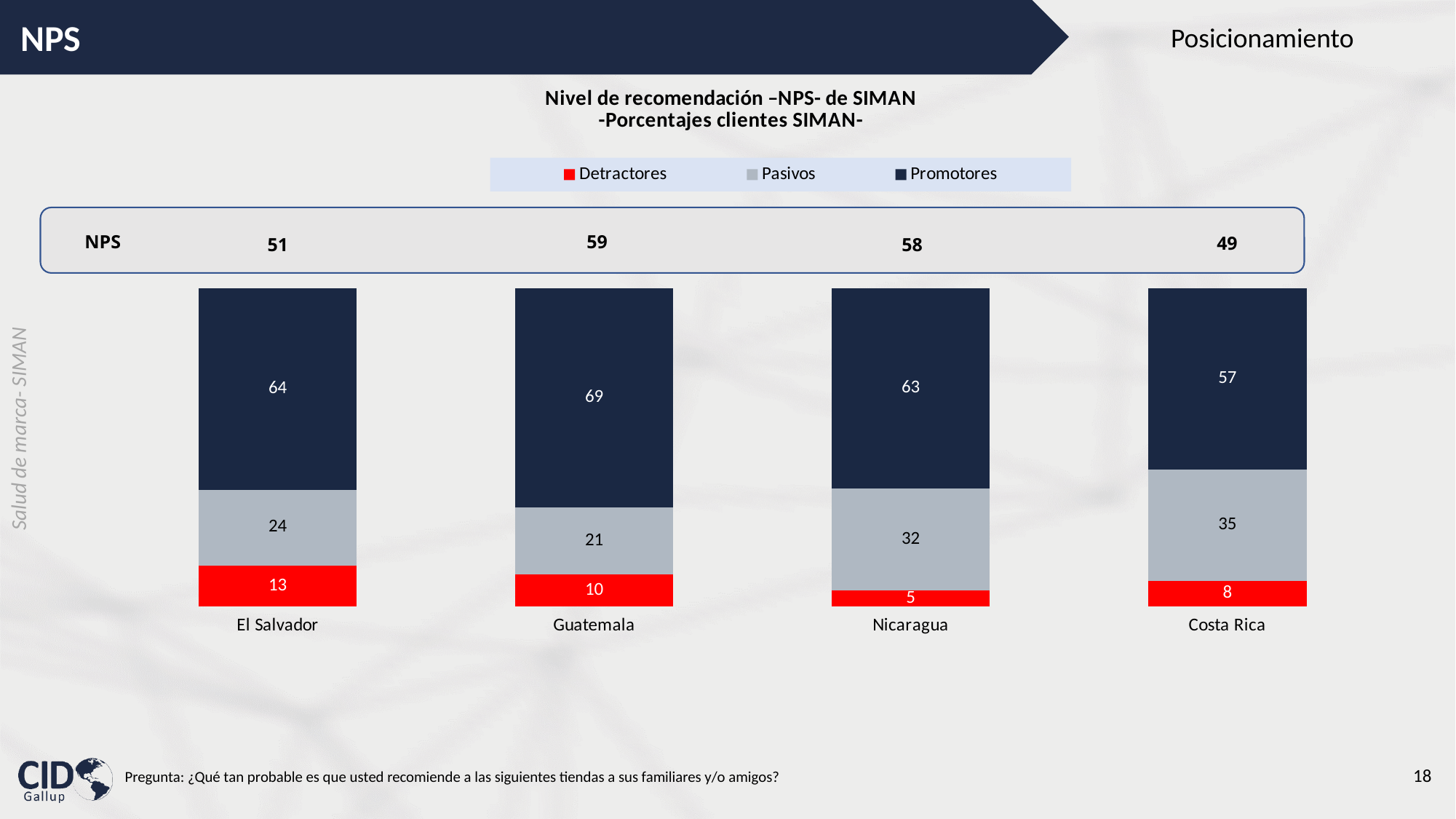
What is the difference between the Promotores values for El Salvador and Costa Rica? 7 Which country has the highest Promotores value? Guatemala Which country has the lowest Detractores value? Nicaragua What kind of chart is shown? Stacked bar chart What is the Pasivos value for Nicaragua? 32 How many countries are shown on the x axis? 4 What is the Promotores value for Guatemala? 69 Which colour represents Detractores in the legend? Red Which is larger, the Pasivos value for Costa Rica or for El Salvador? Costa Rica How many series does the legend list? 3 What is the total of the stacked bar for Nicaragua? 100 What is the Detractores value for Costa Rica? 8